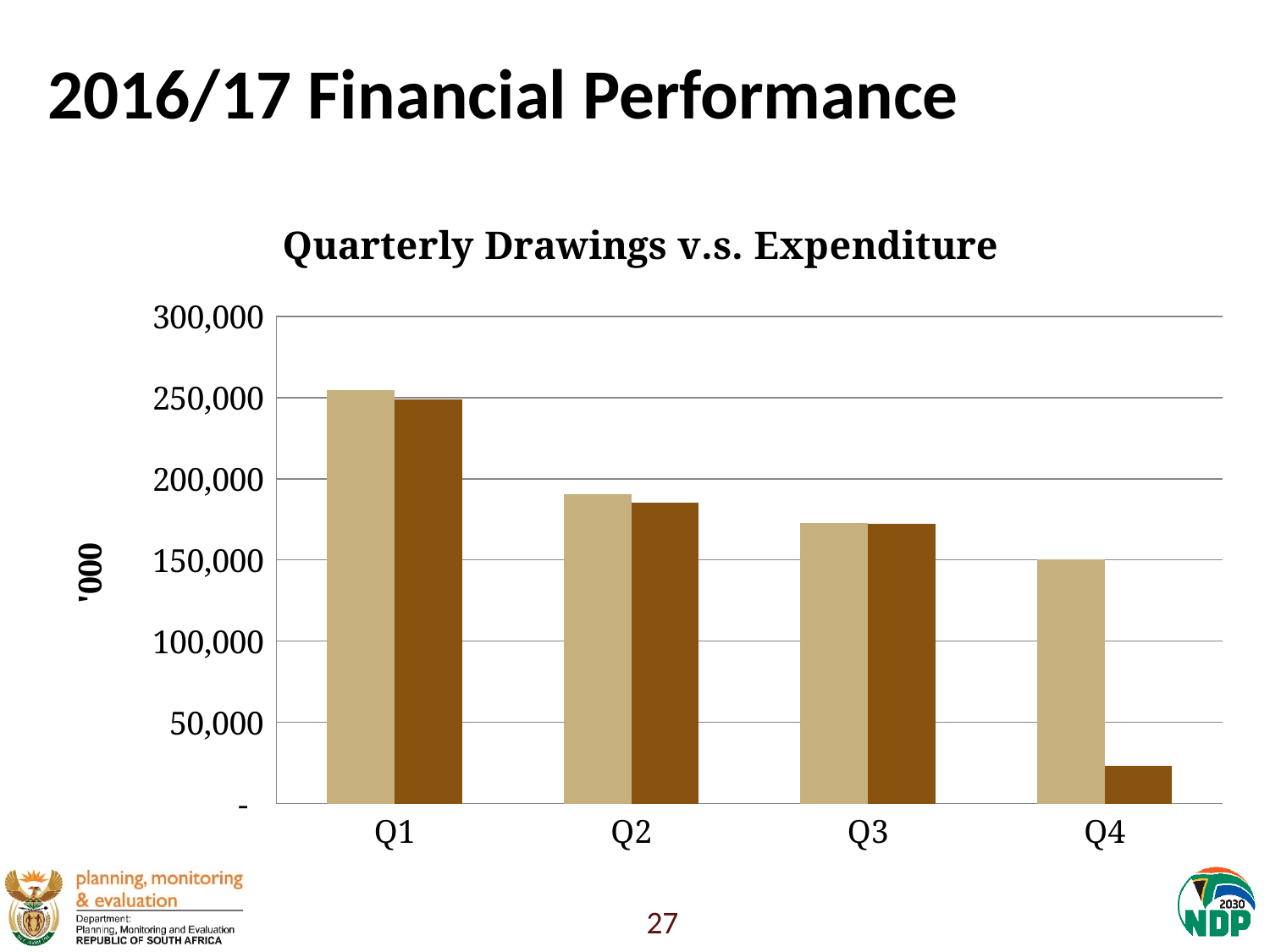
Is the value of the light tan bar for Q2 greater or less than 200,000? less What is the title of the chart? Quarterly Drawings v.s. Expenditure Which quarter has the shortest dark brown bar? Q4 Is the light tan bar for Q1 larger or smaller than the light tan bar for Q2? larger Is the value of the dark brown bar for Q4 greater or less than 50,000? less How many quarters are shown on the x axis of the chart? 4 What is the label on the vertical axis of the chart? '000 Is the value of the light tan bar for Q3 greater or less than 150,000? greater Which quarter has the tallest light tan bar? Q1 What kind of chart is shown on the slide? bar chart In Q4, which bar is larger, the light tan bar or the dark brown bar? the light tan bar Do the light tan bars rise or fall from Q1 to Q4? fall